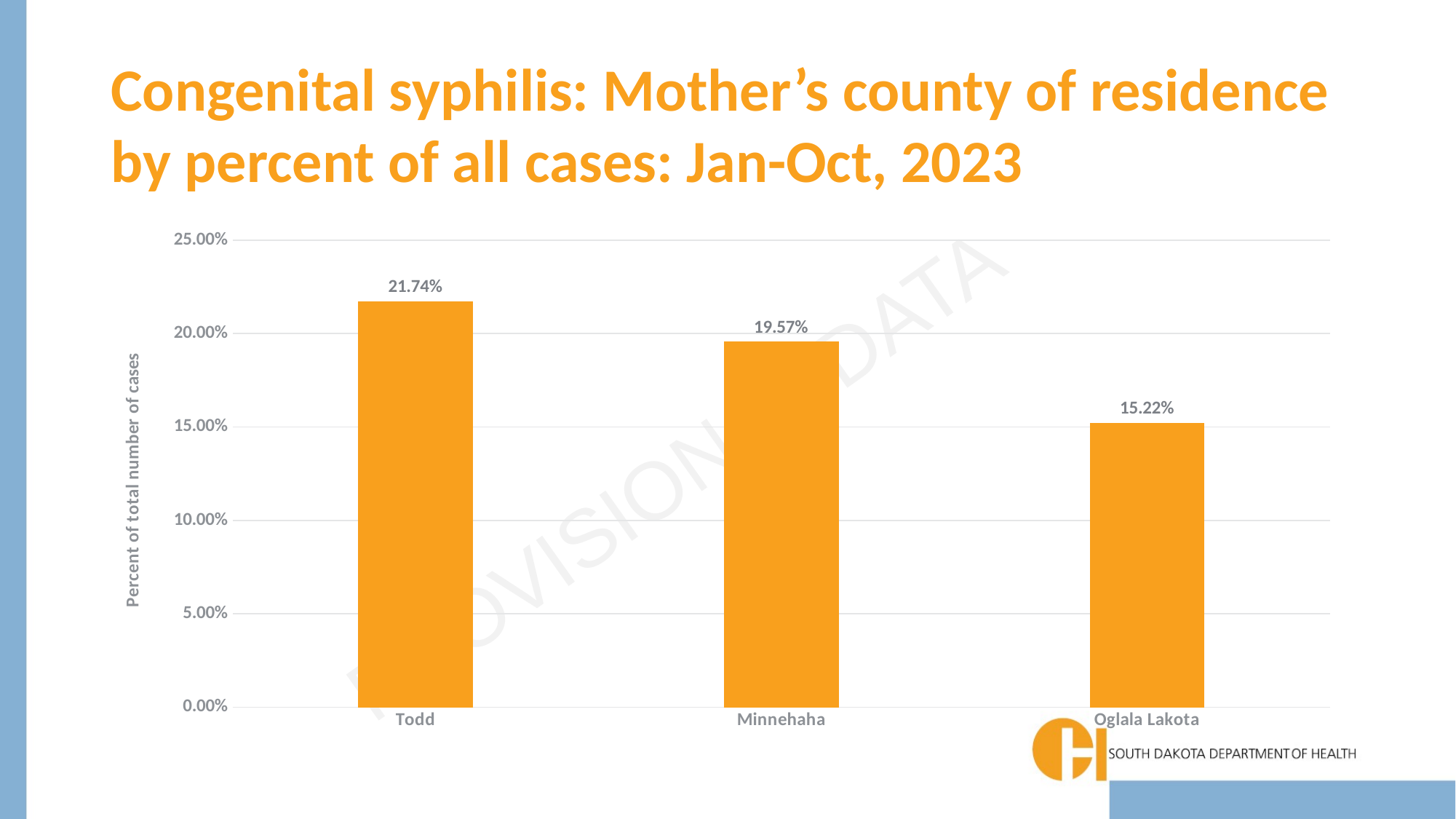
Is the value for Minnehaha greater or less than 20.00%? less What kind of chart is shown on the slide? bar chart How many counties are shown in the chart? 3 What is the difference between the values for Minnehaha and Oglala Lakota? 4.35% What is the value for Minnehaha? 19.57% What is the difference between the values for Todd and Minnehaha? 2.17% Which county has the lowest percent of cases? Oglala Lakota What is the value for Todd? 21.74% Which county has the highest percent of cases? Todd What is the value for Oglala Lakota? 15.22% Which is larger, the value for Todd or the value for Oglala Lakota? Todd What is the label of the vertical axis? Percent of total number of cases